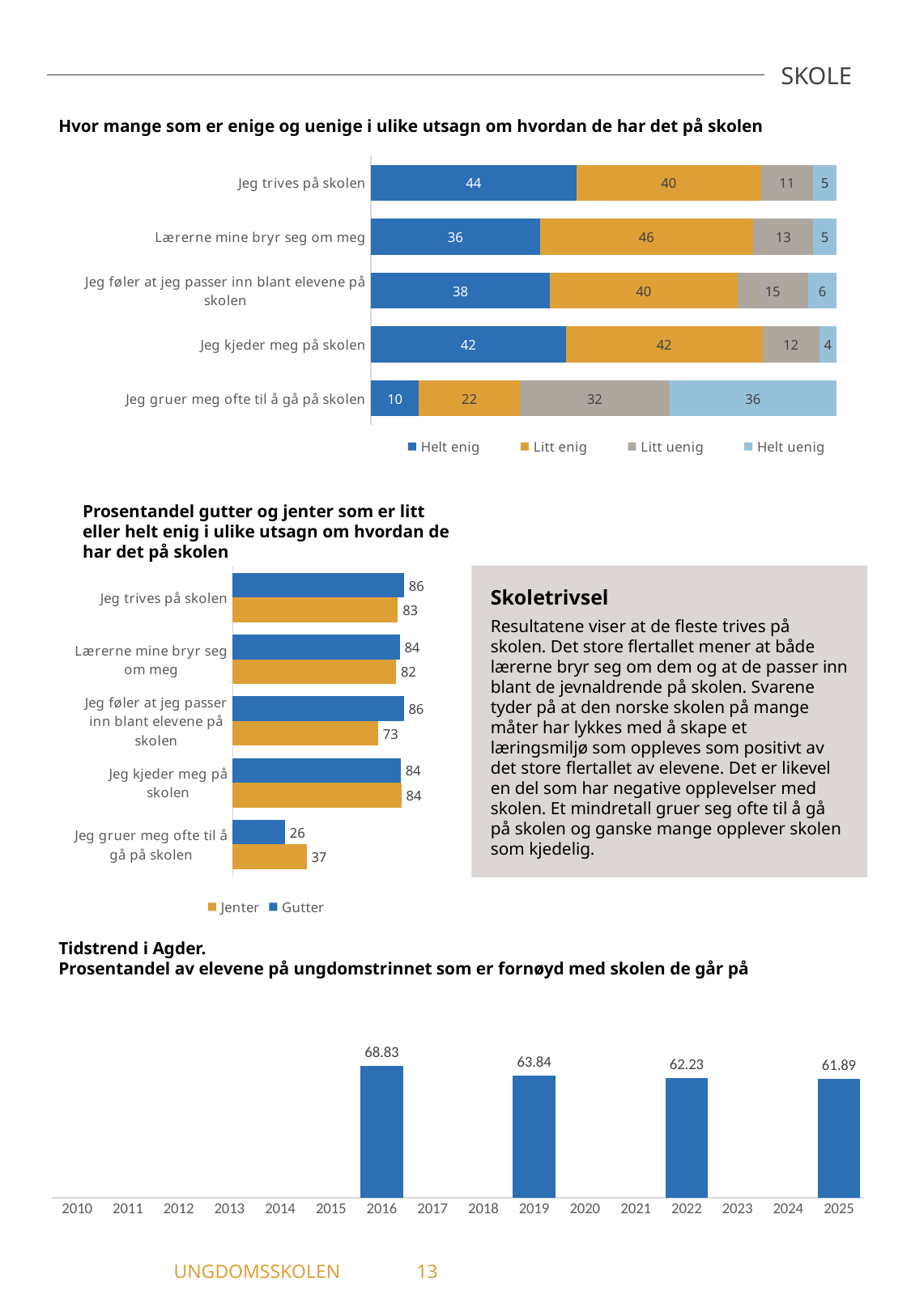
In the chart 'Prosentandel gutter og jenter som er litt eller helt enig i ulike utsagn om hvordan de har det på skolen', which is larger for 'Jeg trives på skolen', Gutter or Jenter? Gutter In the chart 'Prosentandel gutter og jenter som er litt eller helt enig i ulike utsagn om hvordan de har det på skolen', how many statements are shown? 5 In the chart 'Hvor mange som er enige og uenige i ulike utsagn om hvordan de har det på skolen', what is the total of the stacked bar for 'Jeg kjeder meg på skolen'? 100 In the chart 'Hvor mange som er enige og uenige i ulike utsagn om hvordan de har det på skolen', which statement has the lowest 'Helt enig' value? Jeg gruer meg ofte til å gå på skolen In the chart 'Prosentandel gutter og jenter som er litt eller helt enig i ulike utsagn om hvordan de har det på skolen', what is the value for Jenter on 'Jeg føler at jeg passer inn blant elevene på skolen'? 73 In the chart 'Tidstrend i Agder', what is the value for 2016? 68.83 In the chart 'Tidstrend i Agder', do the values rise or fall from 2016 to 2025? fall In the chart 'Hvor mange som er enige og uenige i ulike utsagn om hvordan de har det på skolen', what is the 'Helt uenig' value for 'Jeg gruer meg ofte til å gå på skolen'? 36 In the chart 'Prosentandel gutter og jenter som er litt eller helt enig i ulike utsagn om hvordan de har det på skolen', what is the difference between Jenter and Gutter for 'Jeg gruer meg ofte til å gå på skolen'? 11 In the chart 'Hvor mange som er enige og uenige i ulike utsagn om hvordan de har det på skolen', how many series does the legend list? 4 In the chart 'Hvor mange som er enige og uenige i ulike utsagn om hvordan de har det på skolen', what is the 'Helt enig' value for 'Jeg trives på skolen'? 44 What kind of chart is 'Tidstrend i Agder'? bar chart